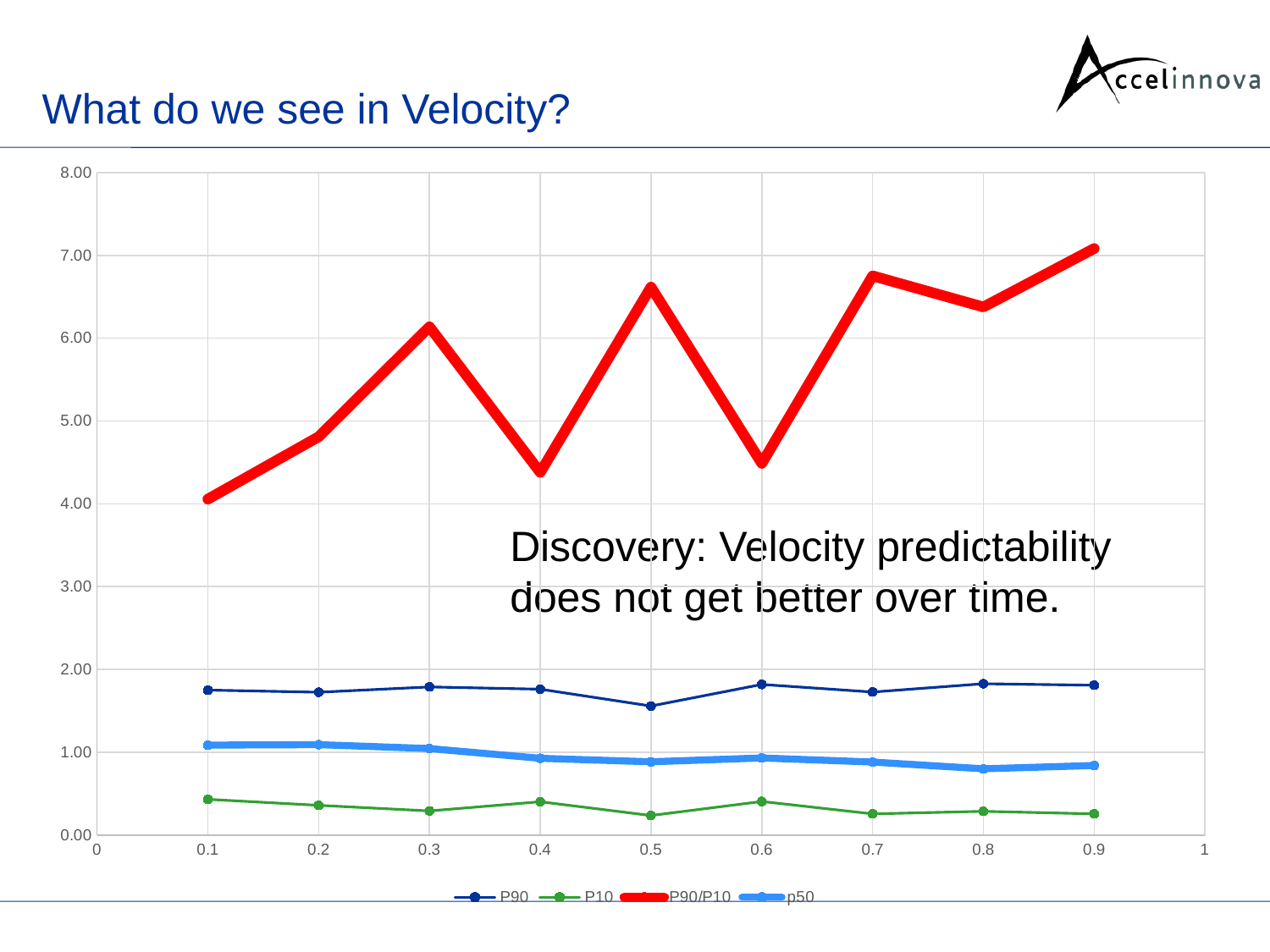
Is the value of P90/P10 at x = 0.9 greater or less than 7.00? greater Is the value of p50 at x = 0.8 greater or less than 1.00? less At which x value is the P10 series highest? 0.1 At which x value is the P90/P10 series highest? 0.9 At which x value is the P90 series lowest? 0.5 What kind of chart is shown on the slide? line chart How many series does the legend list? 4 At which x value is the P90/P10 series lowest? 0.1 Is the value of P90/P10 at x = 0.4 greater or less than 5.00? less Which series is drawn as the thick red line? P90/P10 Which is larger for the P90/P10 series: the value at x = 0.5 or at x = 0.6? 0.5 How many data points does the P90/P10 series have? 9